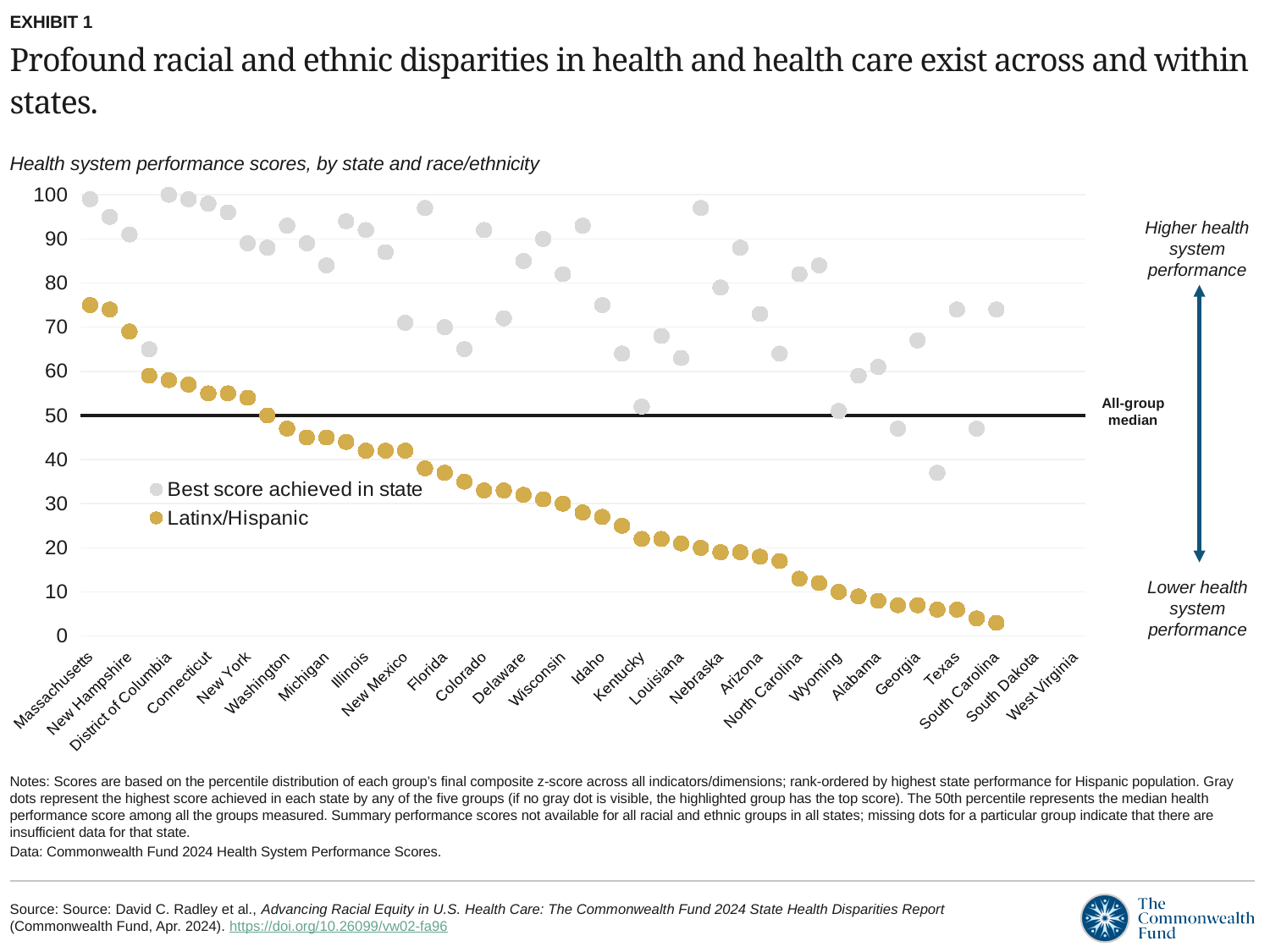
For Florida, which is larger: the best score achieved in state or the Latinx/Hispanic score? Best score achieved in state What kind of chart is shown on the slide? Dot (scatter) chart Is the Latinx/Hispanic score for Texas greater or less than 10? less At what score is the 'All-group median' line drawn? 50 Is the Latinx/Hispanic score for Connecticut greater or less than 50? greater Is the Latinx/Hispanic score for Massachusetts greater or less than 70? greater Which state has the lowest Latinx/Hispanic score? South Carolina How many series does the legend list? 2 Do the Latinx/Hispanic scores rise or fall moving from left to right along the x axis? Fall Which is larger, the Latinx/Hispanic score for Massachusetts or for Texas? Massachusetts What are the two series named in the legend? Best score achieved in state; Latinx/Hispanic